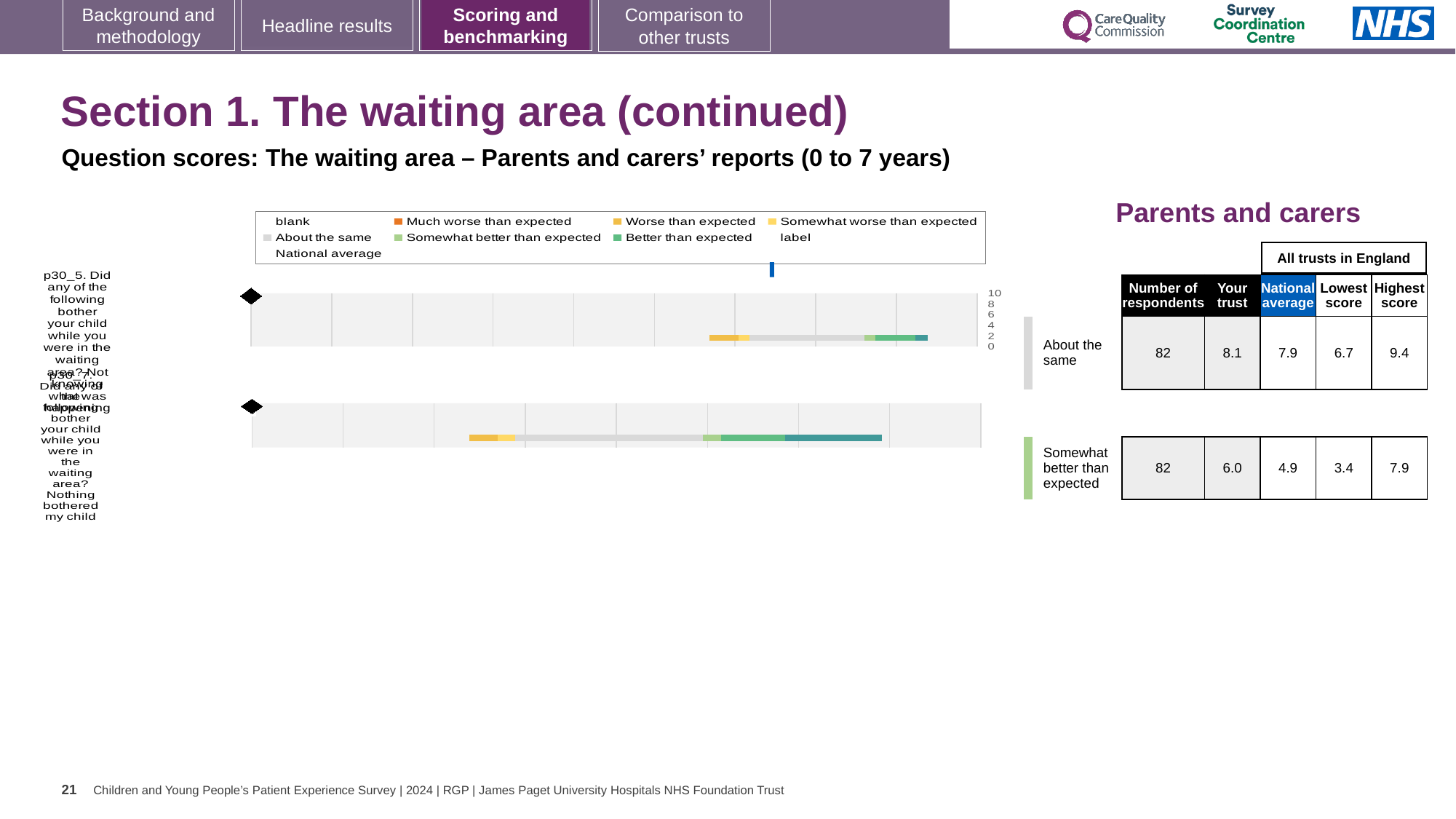
What heading appears above the table to the right of the chart? Parents and carers In the table, how many respondents are listed for the question rated 'About the same'? 82 How many question bars are plotted in the chart? 2 In the table, what is the highest score for the question rated 'About the same'? 9.4 For the question rated 'About the same', which is larger: the 'Your trust' score or the national average? Your trust What kind of chart is shown on the slide? bar chart How many entries does the chart legend list? 9 In the table, what is the 'Your trust' score for the question rated 'About the same'? 8.1 What colour does the legend use for 'Much worse than expected'? orange In the table, what is the lowest score for the question rated 'Somewhat better than expected'? 3.4 For the question rated 'Somewhat better than expected', what is the difference between the 'Your trust' score and the national average? 1.1 In the table, what is the national average for the question rated 'Somewhat better than expected'? 4.9